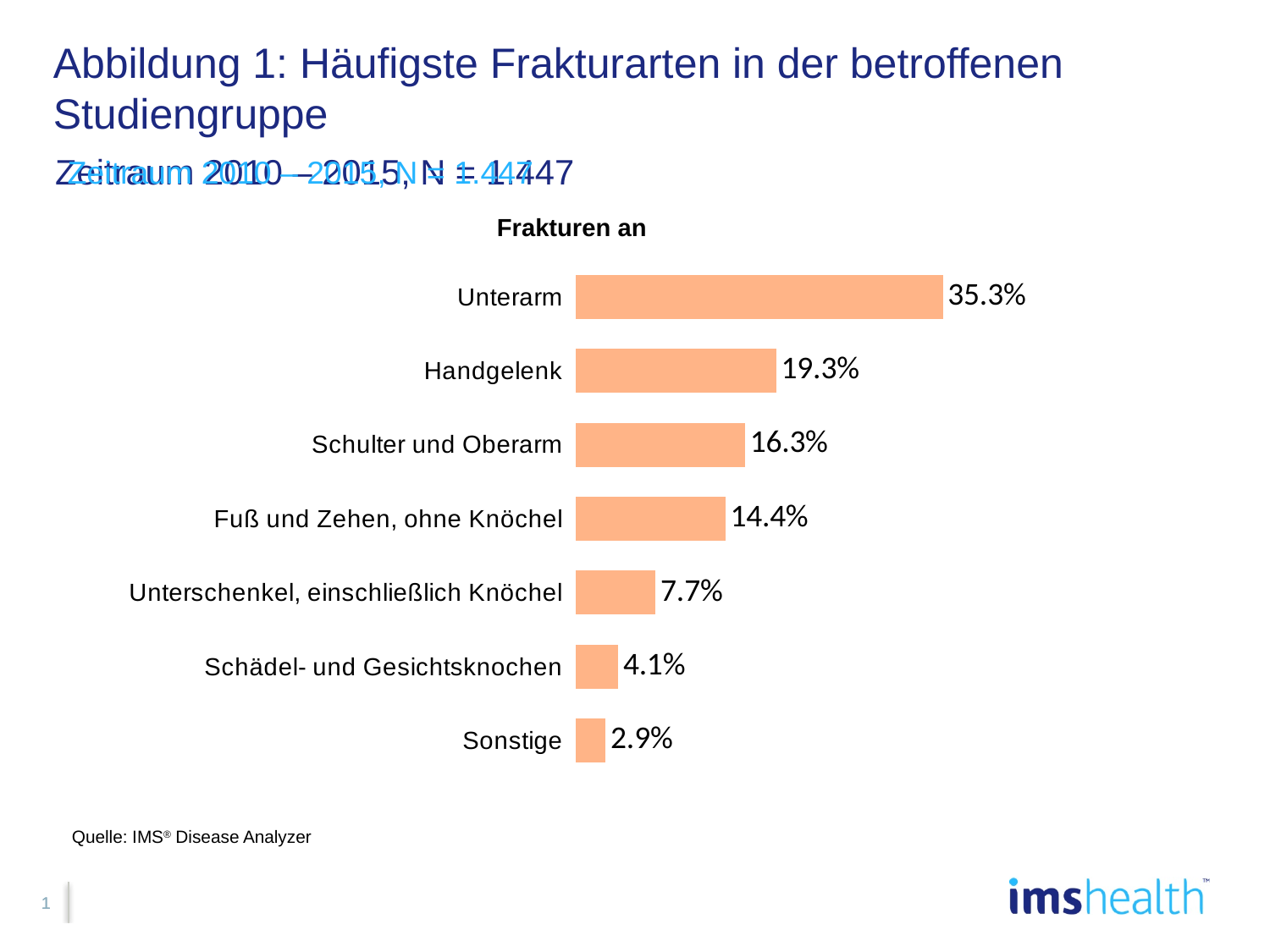
Which is larger, the value for Unterschenkel, einschließlich Knöchel or the value for Schädel- und Gesichtsknochen? Unterschenkel, einschließlich Knöchel What is the value for Handgelenk? 19.3% What is the value for Schädel- und Gesichtsknochen? 4.1% What kind of chart is shown on the slide? Bar chart What is the value for Unterarm? 35.3% What is the value for Fuß und Zehen, ohne Knöchel? 14.4% Which category has the lowest value? Sonstige What is the title of the chart? Frakturen an Which category has the highest value? Unterarm What is the difference between the values for Schulter und Oberarm and Fuß und Zehen, ohne Knöchel? 1.9% How many categories are shown in the chart? 7 What is the difference between the values for Unterarm and Handgelenk? 16.0%